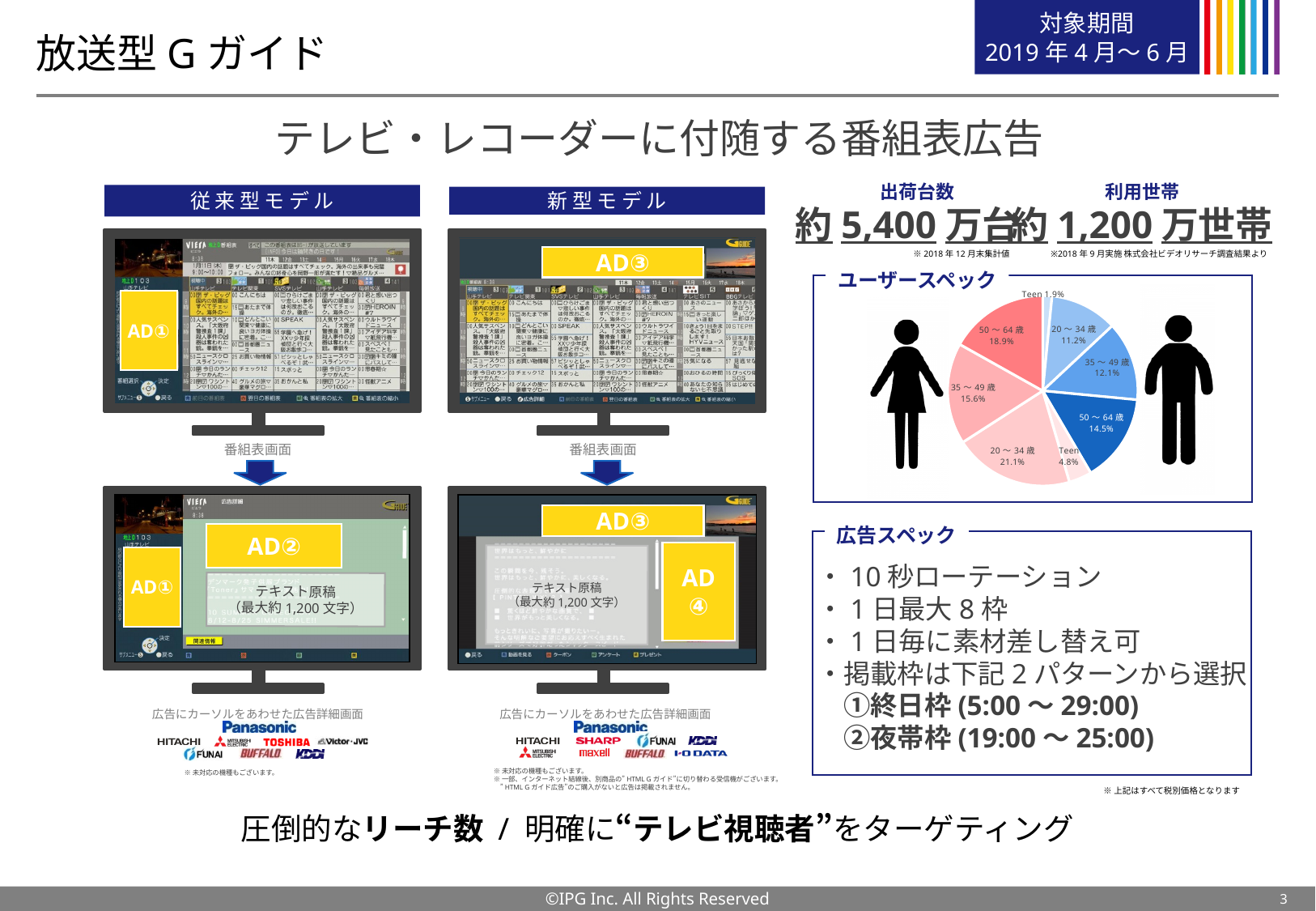
In the ユーザースペック pie chart, which is larger: the blue 35～49歳 slice or the pink 35～49歳 slice? Pink 35～49歳 (15.6%) In the ユーザースペック pie chart, what share is the blue 50～64歳 slice? 14.5% What kind of chart is shown in the ユーザースペック box? Pie chart In the ユーザースペック pie chart, how many percentage points larger is the pink 50～64歳 slice than the blue 50～64歳 slice? 4.4 percentage points In the ユーザースペック pie chart, what share is the pink Teen slice? 4.8% What is the heading of the box containing the pie chart? ユーザースペック Which slice of the ユーザースペック pie chart is the smallest? Blue Teen (1.9%) Which slice of the ユーザースペック pie chart is the largest? Pink 20～34歳 (21.1%) In the ユーザースペック pie chart, what is the difference between the pink 20～34歳 slice and the blue 20～34歳 slice? 9.9 percentage points In the ユーザースペック pie chart, what share is the pink 20～34歳 slice? 21.1% In the ユーザースペック pie chart, what is the combined share of the four blue slices? 39.7% How many slices does the ユーザースペック pie chart have? 8